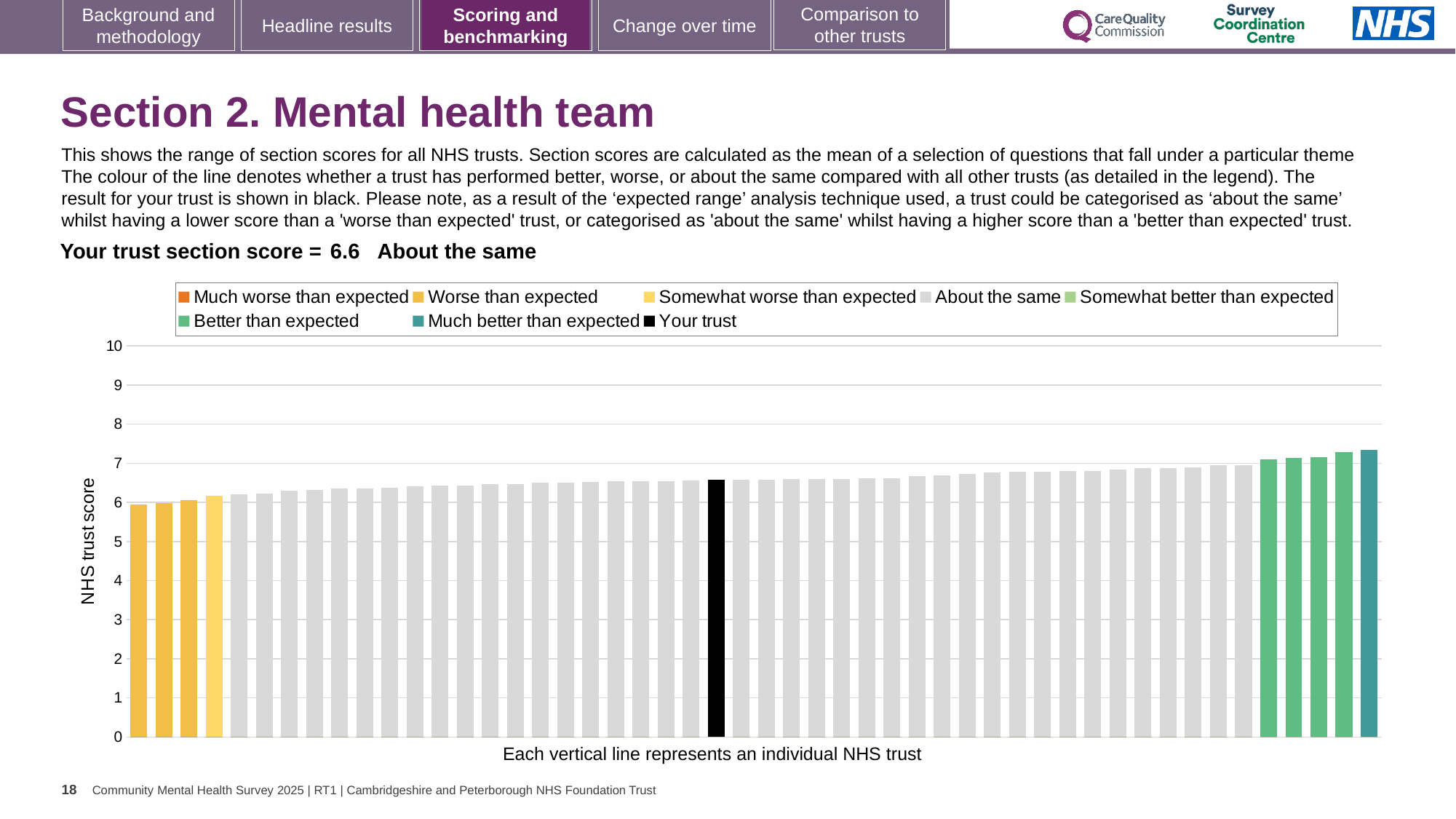
Which legend category does the highest bar in the chart belong to? Much better than expected Is the value of the highest bar in the chart greater or less than 8? less Is the value for your trust's bar greater or less than 6? greater How many bars are coloured as 'Better than expected'? 4 Do the bar values rise or fall from left to right along the x axis? Rise Is the value of the lowest bar in the chart greater or less than 5? greater What is the label on the y axis of the chart? NHS trust score What kind of chart is shown on the slide? Bar chart Which category is your trust placed in for this section? About the same How many entries does the chart legend list? 8 What is the section score for your trust shown on the slide? 6.6 What colour is the bar representing your trust? Black